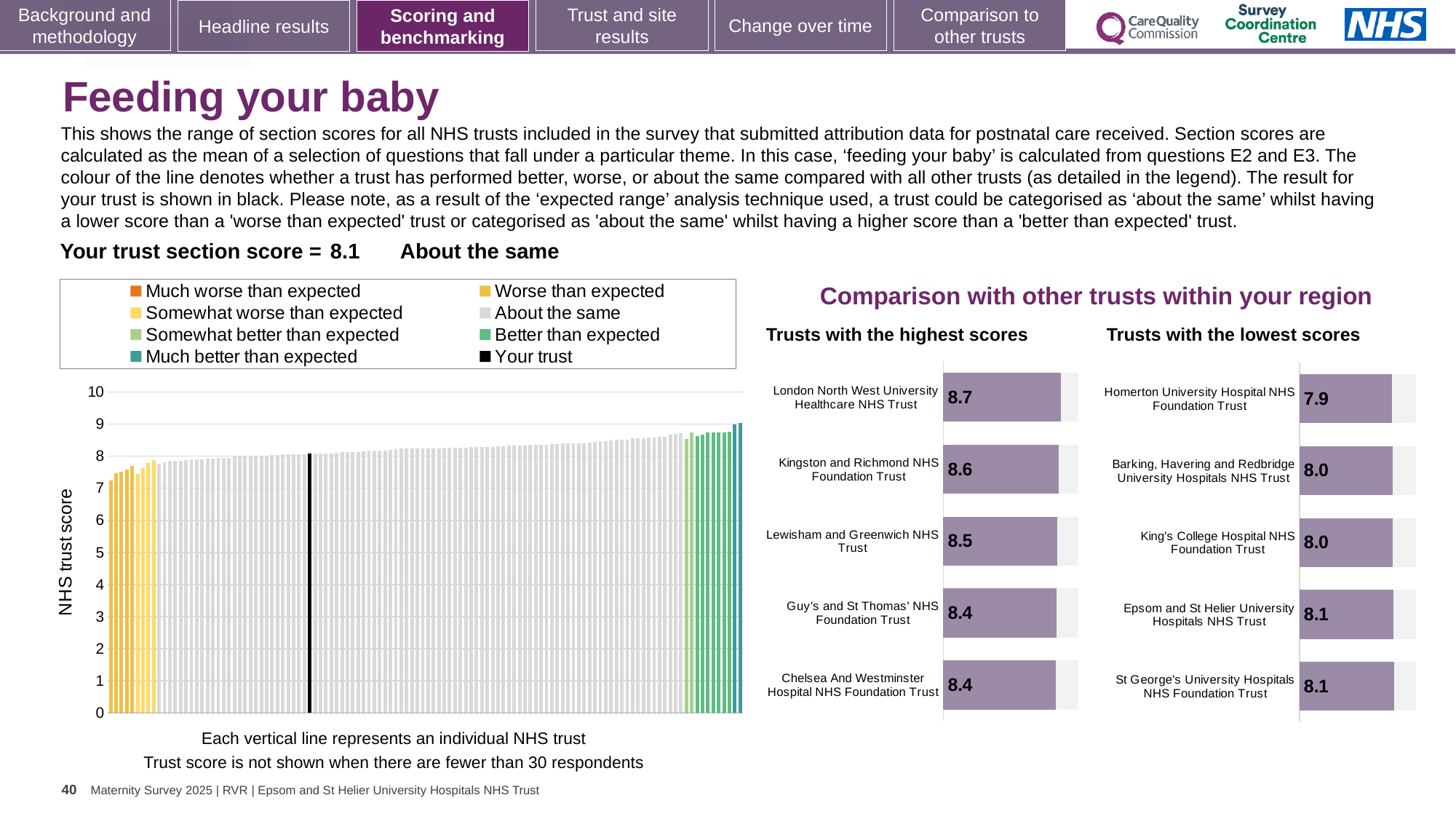
In the 'Trusts with the highest scores' chart, which trust has the highest score? London North West University Healthcare NHS Trust In the 'Trusts with the highest scores' chart, what is the difference between the scores of London North West University Healthcare NHS Trust and Guy's and St Thomas' NHS Foundation Trust? 0.3 What is the y-axis label of the large chart on the left? NHS trust score How many trusts are shown in the 'Trusts with the lowest scores' chart? 5 In the 'Trusts with the highest scores' chart, what is the score for Lewisham and Greenwich NHS Trust? 8.5 What type of chart is the large chart on the left showing NHS trust scores? Bar chart In the 'Trusts with the lowest scores' chart, which has the larger score: Barking, Havering and Redbridge University Hospitals NHS Trust or Homerton University Hospital NHS Foundation Trust? Barking, Havering and Redbridge University Hospitals NHS Trust In the 'Trusts with the lowest scores' chart, which trust has the lowest score? Homerton University Hospital NHS Foundation Trust In the 'Trusts with the highest scores' chart, what is the score for London North West University Healthcare NHS Trust? 8.7 In the large chart on the left, is the value for the leftmost (lowest) bar greater or less than 8? less In the 'Trusts with the lowest scores' chart, what is the score for Homerton University Hospital NHS Foundation Trust? 7.9 How many entries does the legend of the large chart on the left list? 8